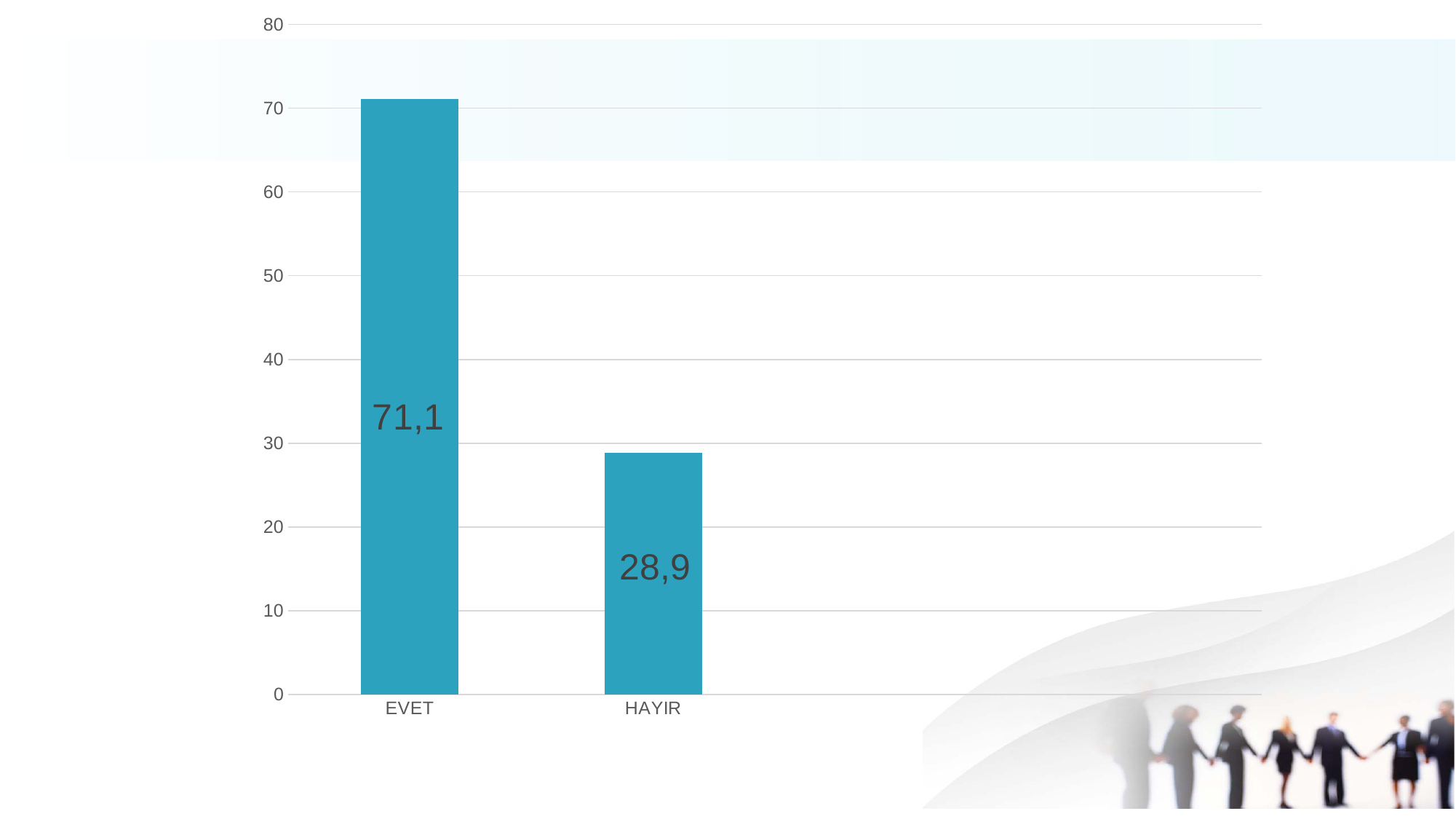
Which is larger, the value for EVET or the value for HAYIR? EVET What is the difference between the values for EVET and HAYIR? 42,2 Which category has the highest value? EVET Which category has the lowest value? HAYIR What is the value for HAYIR? 28,9 Is the value for HAYIR greater or less than 30? less Do the values rise or fall from EVET to HAYIR? fall What is the value for EVET? 71,1 What kind of chart is shown on the slide? bar chart Is the value for EVET greater or less than 70? greater How many categories are shown on the x axis? 2 What is the maximum value shown on the vertical axis? 80